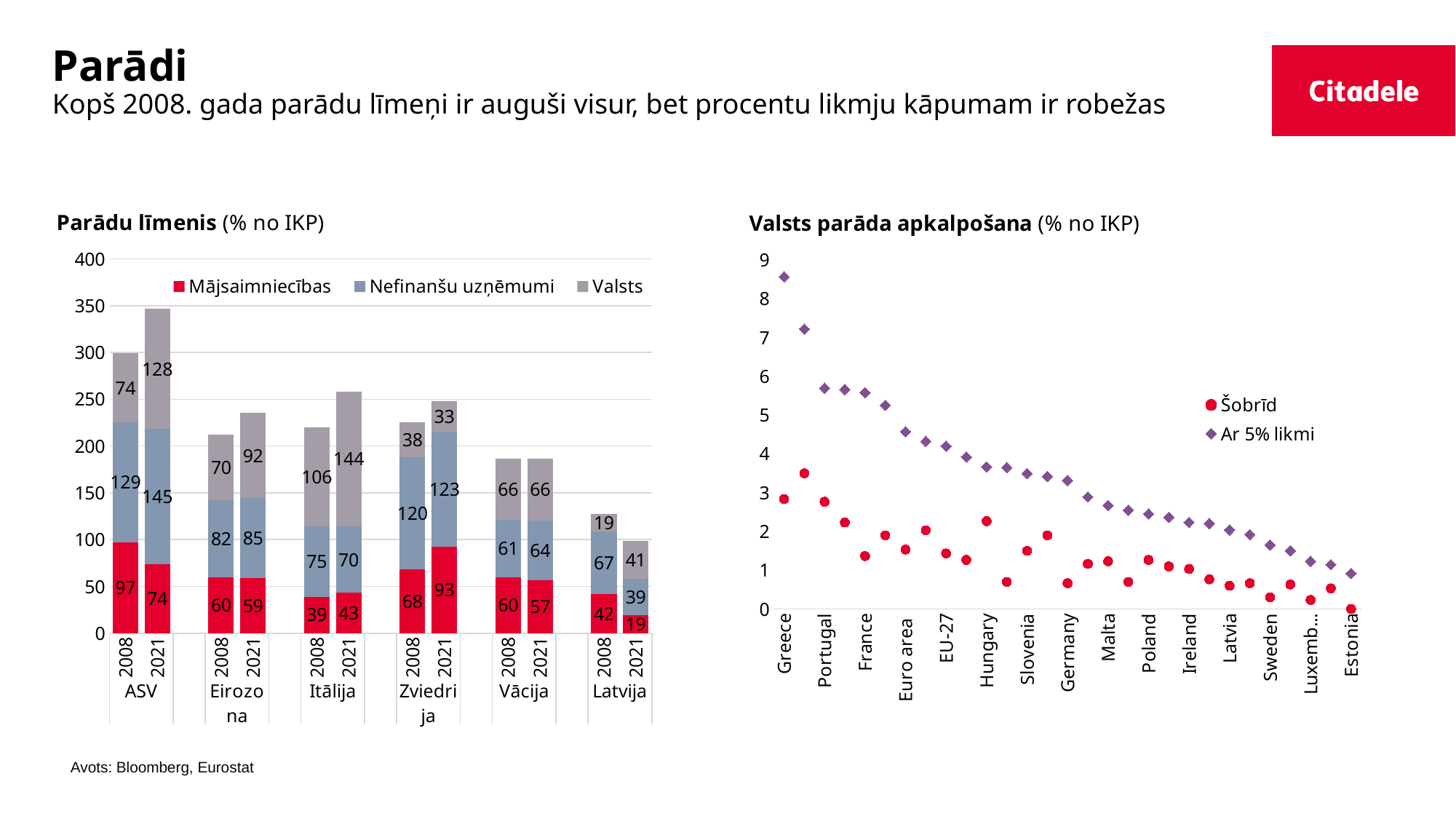
What kind of chart is the 'Parādu līmenis' chart? Stacked bar chart In the 'Parādu līmenis' chart, what is the difference between the Valsts values for Itālija in 2021 and 2008? 38 In the 'Parādu līmenis' chart, what is the total of the stacked bar for ASV in 2008? 300 In the 'Parādu līmenis' chart, what is the total of the stacked bar for Latvija in 2021? 99 In the 'Parādu līmenis' chart, which is larger: the Nefinanšu uzņēmumi value for ASV in 2021 or for Zviedrija in 2021? ASV 2021 In the 'Parādu līmenis' chart, which bar has the highest Valsts value? Itālija 2021 In the 'Parādu līmenis' chart, what is the Mājsaimniecības value for Zviedrija in 2021? 93 How many series does the legend of the 'Parādu līmenis' chart list? 3 In the 'Valsts parāda apkalpošana' chart, do the 'Ar 5% likmi' values rise or fall from Greece to Estonia? fall In the 'Parādu līmenis' chart, what is the Valsts value for ASV in 2021? 128 In the 'Valsts parāda apkalpošana' chart, is the 'Ar 5% likmi' value for Greece greater or less than 8? greater